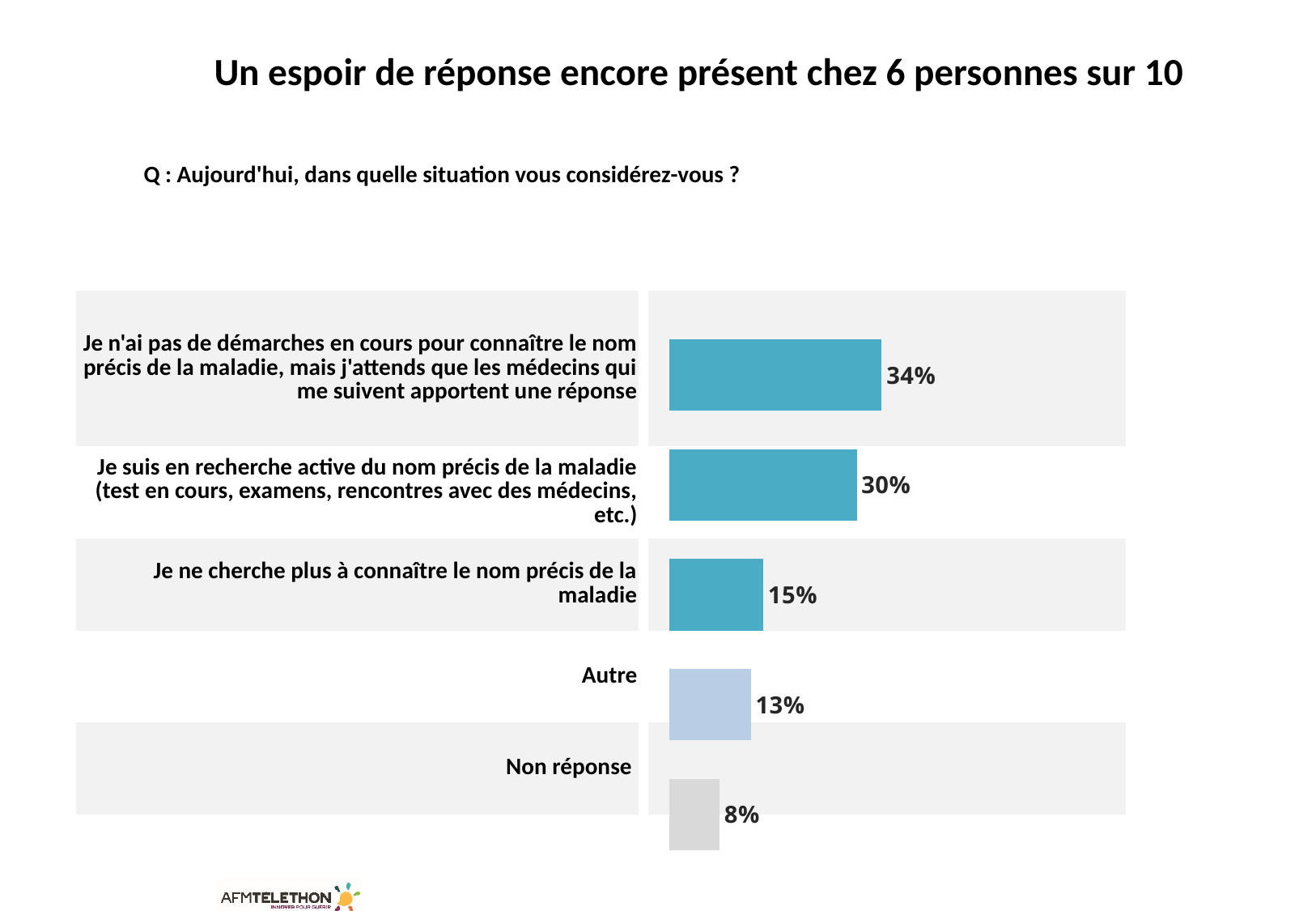
What is the difference between the values for "Autre" and "Non réponse"? 5% What percentage of respondents said they no longer seek to know the precise name of the disease ("Je ne cherche plus à connaître le nom précis de la maladie")? 15% What is the value shown for "Autre"? 13% What is the value shown for "Non réponse"? 8% Which is larger: the value for "Je ne cherche plus à connaître le nom précis de la maladie" or the value for "Autre"? Je ne cherche plus à connaître le nom précis de la maladie Which category has the highest value? Je n'ai pas de démarches en cours pour connaître le nom précis de la maladie, mais j'attends que les médecins qui me suivent apportent une réponse What is the survey question shown above the chart? Q : Aujourd'hui, dans quelle situation vous considérez-vous ? What is the difference between the value for "Je n'ai pas de démarches en cours..." (34%) and "Je suis en recherche active..." (30%)? 4% How many categories are shown in the chart? 5 What percentage of respondents said they are actively searching for the precise name of the disease ("Je suis en recherche active du nom précis de la maladie")? 30% Which category has the lowest value? Non réponse What kind of chart is shown on the slide? Bar chart